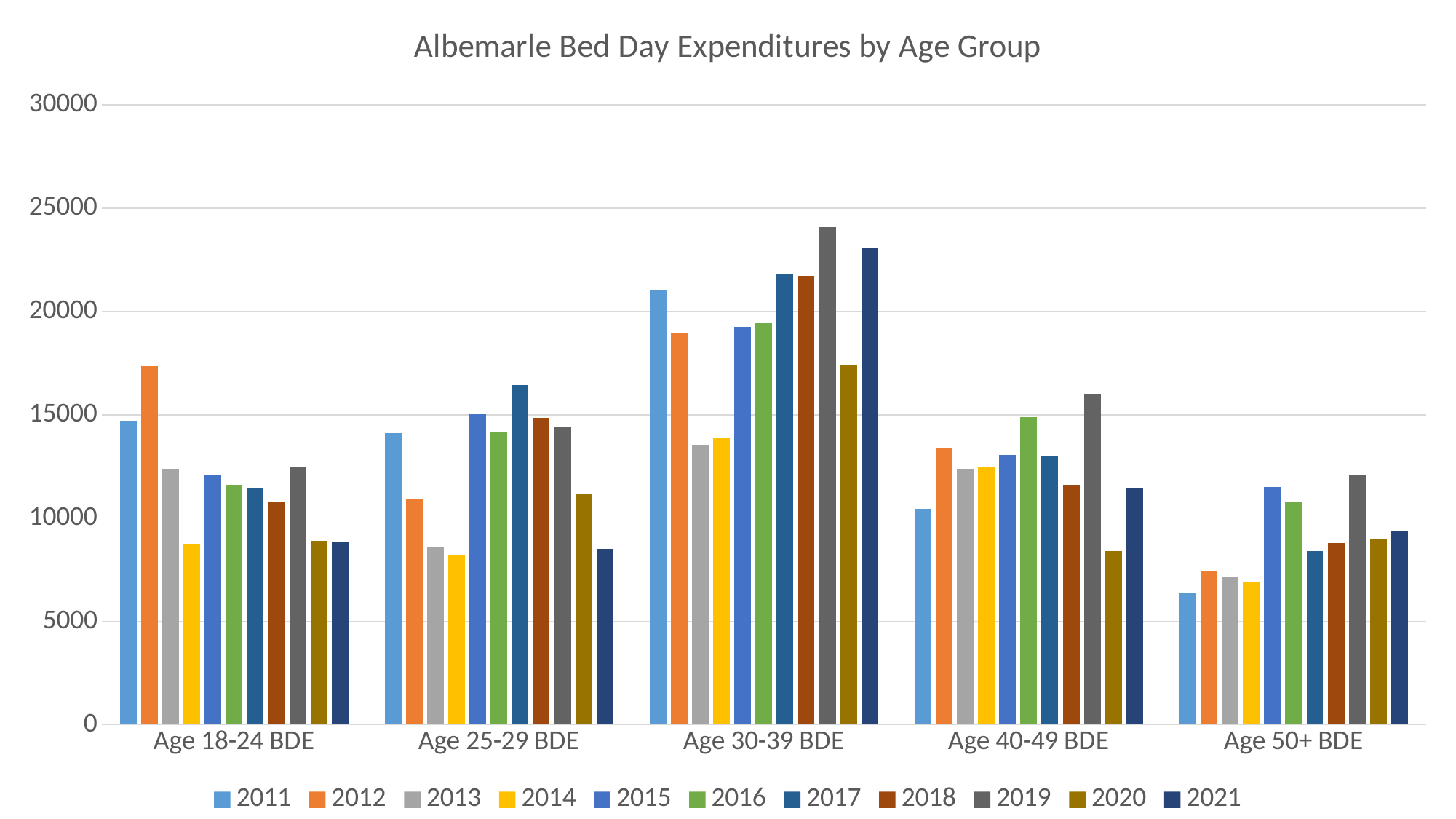
Is the value for 2021 in the Age 30-39 BDE group greater or less than 20000? greater In the Age 40-49 BDE group, which is larger: the 2019 bar or the 2016 bar? 2019 How many series (years) does the legend list? 11 Which age group has the highest bar for 2019? Age 30-39 BDE Within the Age 50+ BDE group, which year has the lowest bar? 2011 Within the Age 18-24 BDE group, which year has the highest bar? 2012 Is the value for 2012 in the Age 18-24 BDE group greater or less than 15000? greater What is the title of the chart? Albemarle Bed Day Expenditures by Age Group How many age group categories are shown on the x axis? 5 What kind of chart is shown on the slide? bar chart Within the Age 30-39 BDE group, which year has the highest bar? 2019 In the Age 25-29 BDE group, which is larger: the 2017 bar or the 2012 bar? 2017